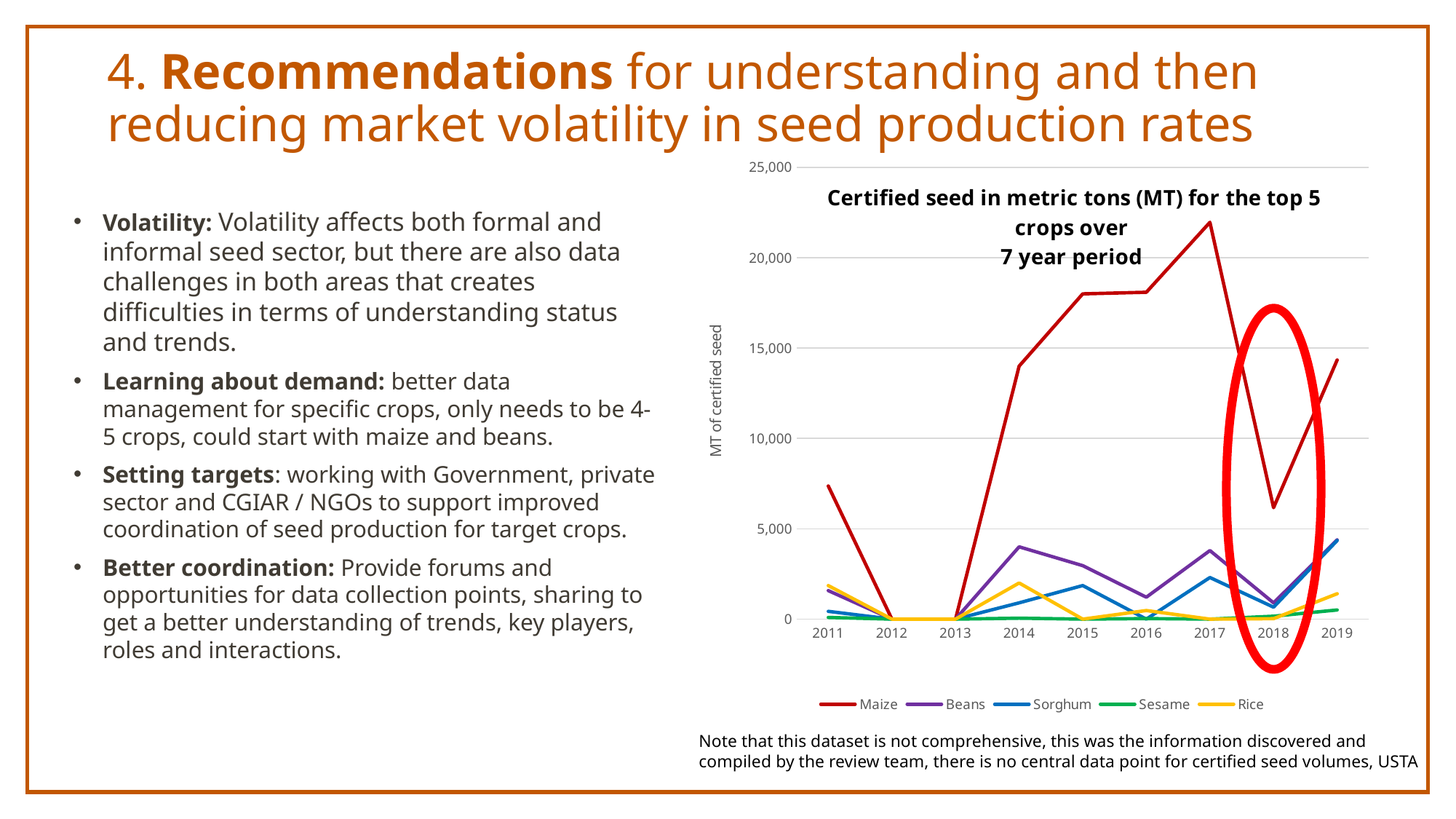
What is the label on the y axis of the chart? MT of certified seed What kind of chart is shown on the slide? line chart Is the value for Maize in 2014 greater or less than 15,000? less Which is larger in 2017, the value for Maize or the value for Beans? Maize How many series does the legend list? 5 Is the value for Maize in 2017 greater or less than 20,000? greater Which series has the highest value in 2019? Maize How many years are plotted along the x axis? 9 Is the value for Beans in 2014 greater or less than 5,000? less In which year does the Maize line reach its highest value? 2017 Does the Maize line rise or fall from 2013 to 2017? rise